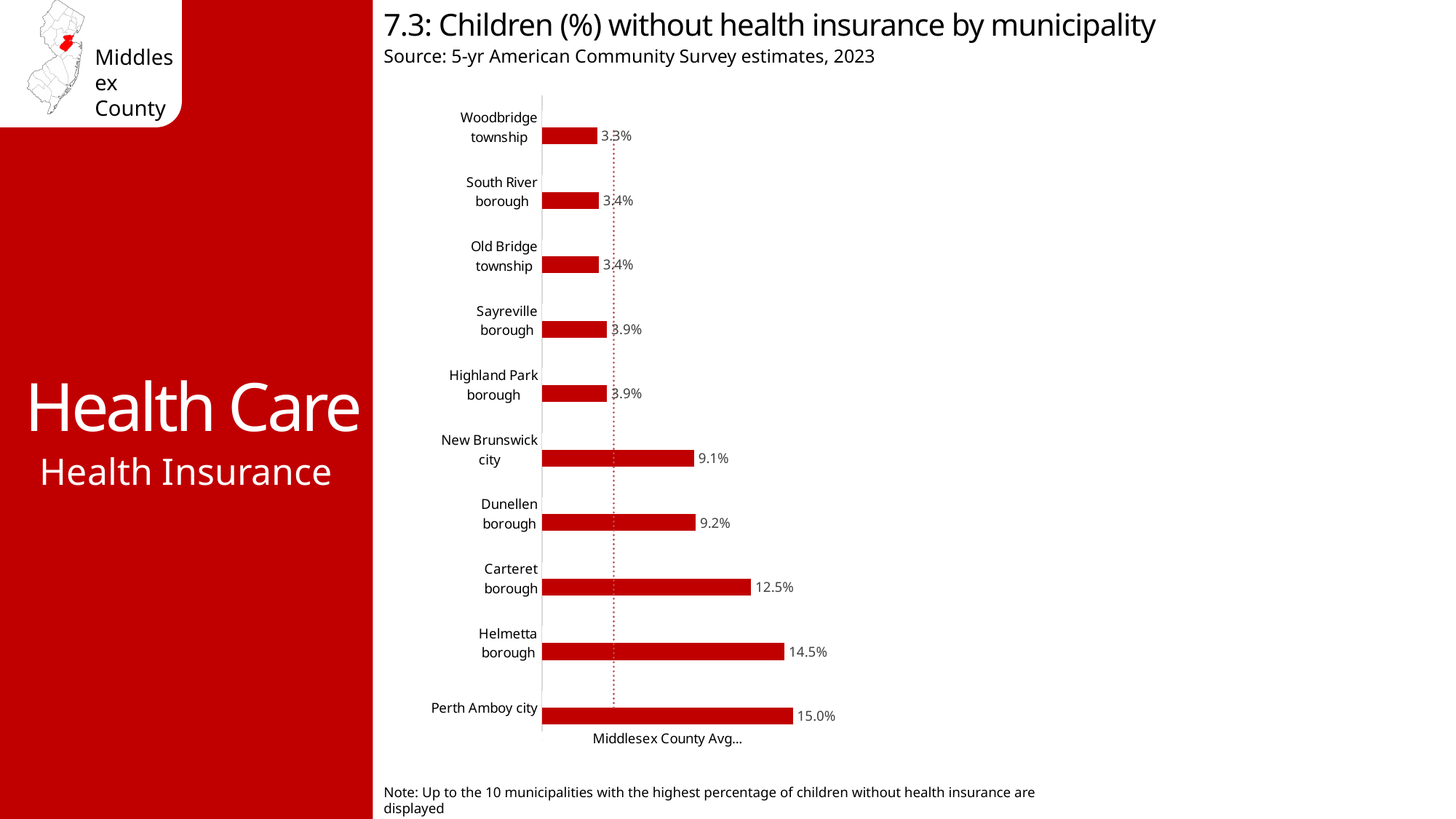
Which municipality has the highest percentage of children without health insurance? Perth Amboy city What is the value shown for Carteret borough? 12.5% What is the difference between the values for Perth Amboy city and Helmetta borough? 0.5% What is the value shown for New Brunswick city? 9.1% What is the difference between the values for Carteret borough and Dunellen borough? 3.3% Which municipality has the lowest percentage of children without health insurance? Woodbridge township What does the dotted vertical line in the chart represent? Middlesex County Avg How many municipalities are shown in the chart? 10 What is the percentage of children without health insurance in Perth Amboy city? 15.0% Which has a higher value, Helmetta borough or Carteret borough? Helmetta borough What kind of chart is shown on the slide? Bar chart What is the value shown for Woodbridge township? 3.3%